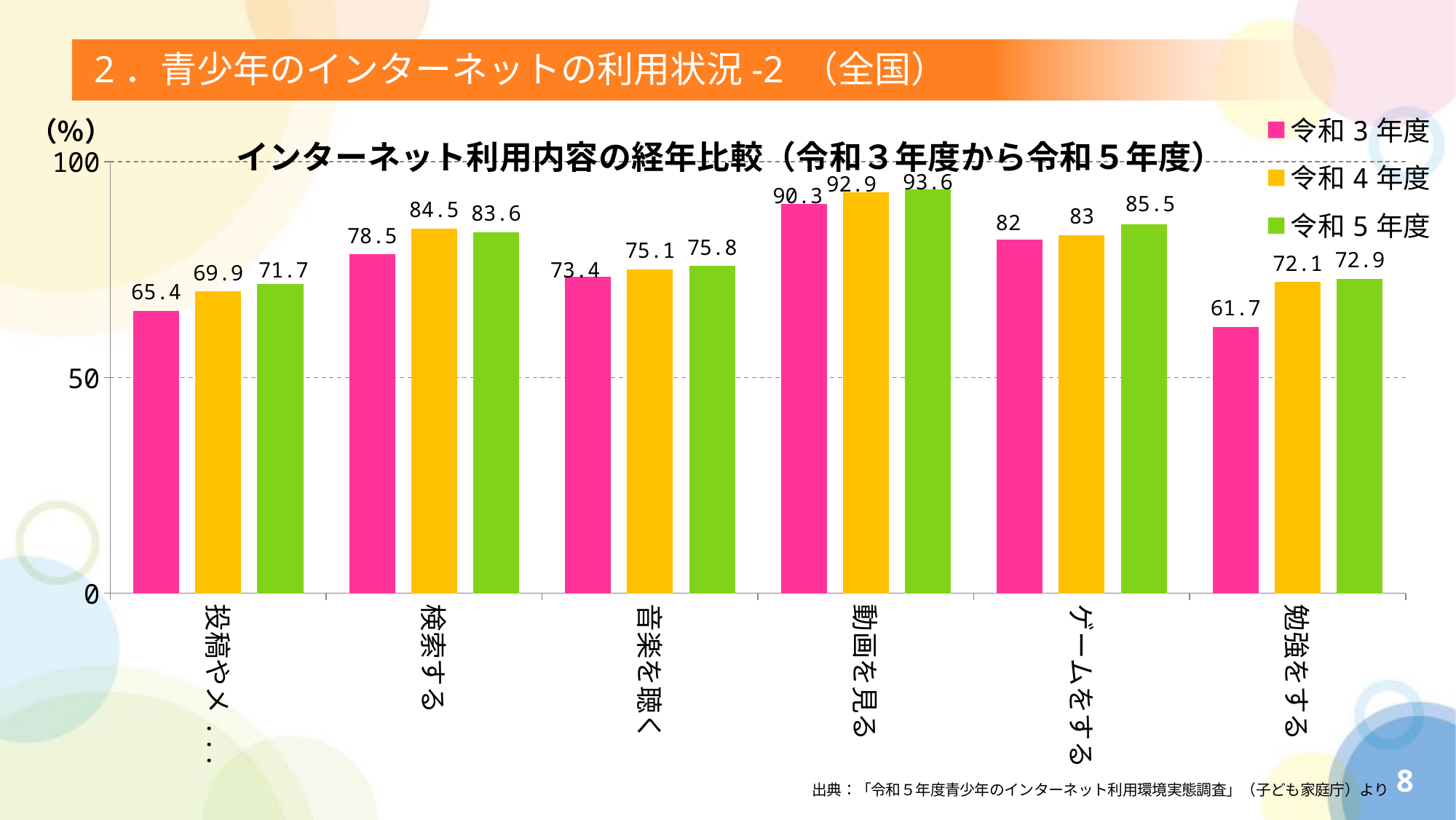
Which category has the highest 令和５年度 value? 動画を見る What is the 令和４年度 value for 検索する? 84.5 How many categories are shown on the x axis? 6 How many series does the legend list? 3 What is the 令和３年度 value for 勉強をする? 61.7 Which category has the lowest 令和３年度 value? 勉強をする What is the 令和５年度 value for 動画を見る? 93.6 What kind of chart is shown on the slide? bar chart What is the difference between the 令和５年度 and 令和３年度 values for 勉強をする? 11.2 What is the title of the chart? インターネット利用内容の経年比較（令和３年度から令和５年度） For 検索する, which is larger: the 令和４年度 value or the 令和５年度 value? 令和４年度 Is the 令和３年度 value for ゲームをする greater or less than 50? greater